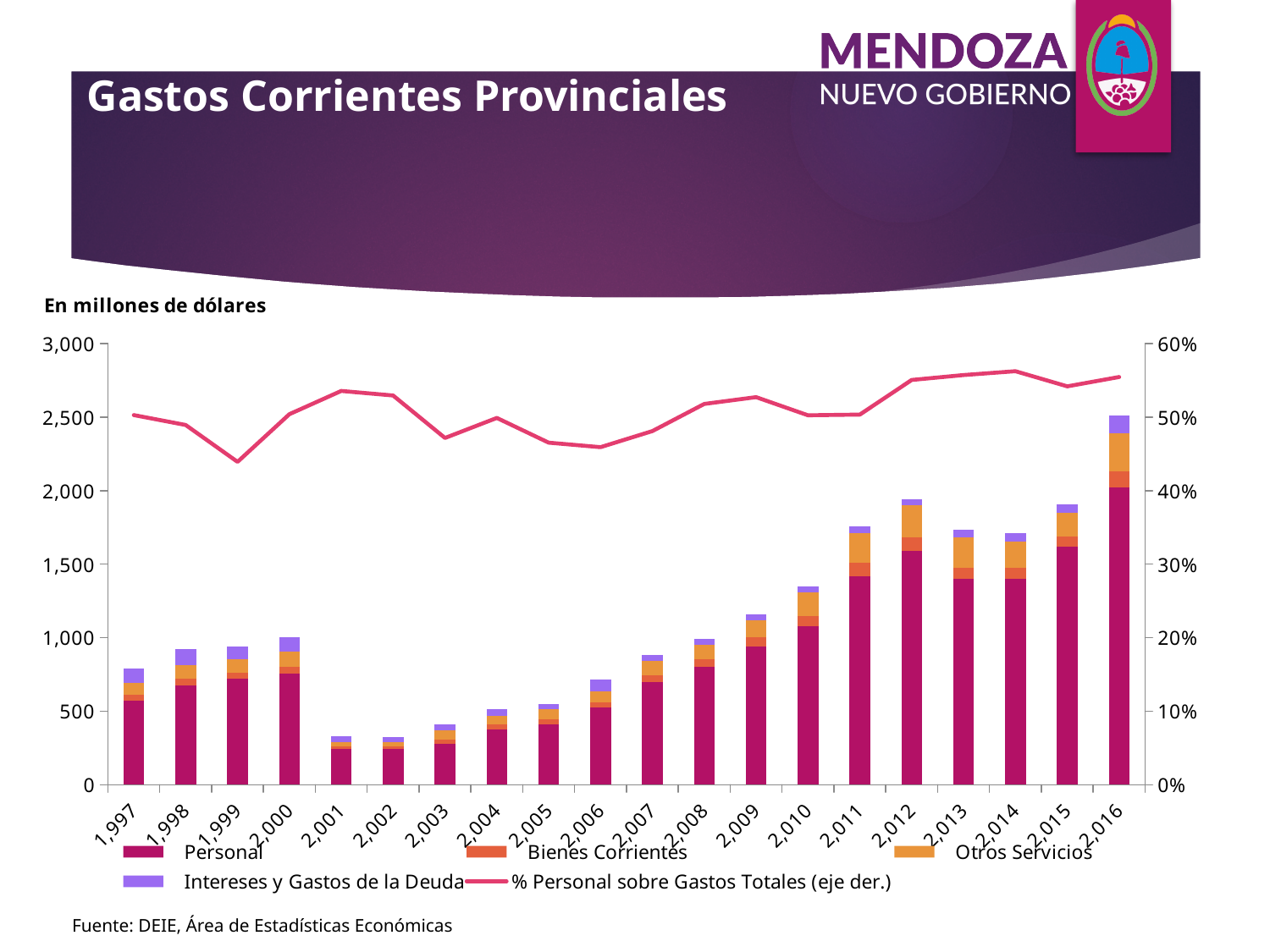
Do the total stacked bars rise or fall from 2002 to 2016? rise Is the total stacked bar for 2016 greater or less than 2,000? greater Is the value of the '% Personal sobre Gastos Totales' line in 2012 greater or less than 50%? greater Which year has the larger total stacked bar, 2012 or 2013? 2012 Which year has the highest total stacked bar? 2016 How many years are shown on the x axis of the chart? 20 What kind of chart is shown on the slide? A stacked bar chart with a line What unit is stated above the chart for the bar values? En millones de dólares Is the value of the '% Personal sobre Gastos Totales' line in 1999 greater or less than 50%? less In which year is the line '% Personal sobre Gastos Totales' at its lowest? 1999 How many series does the legend list? 5